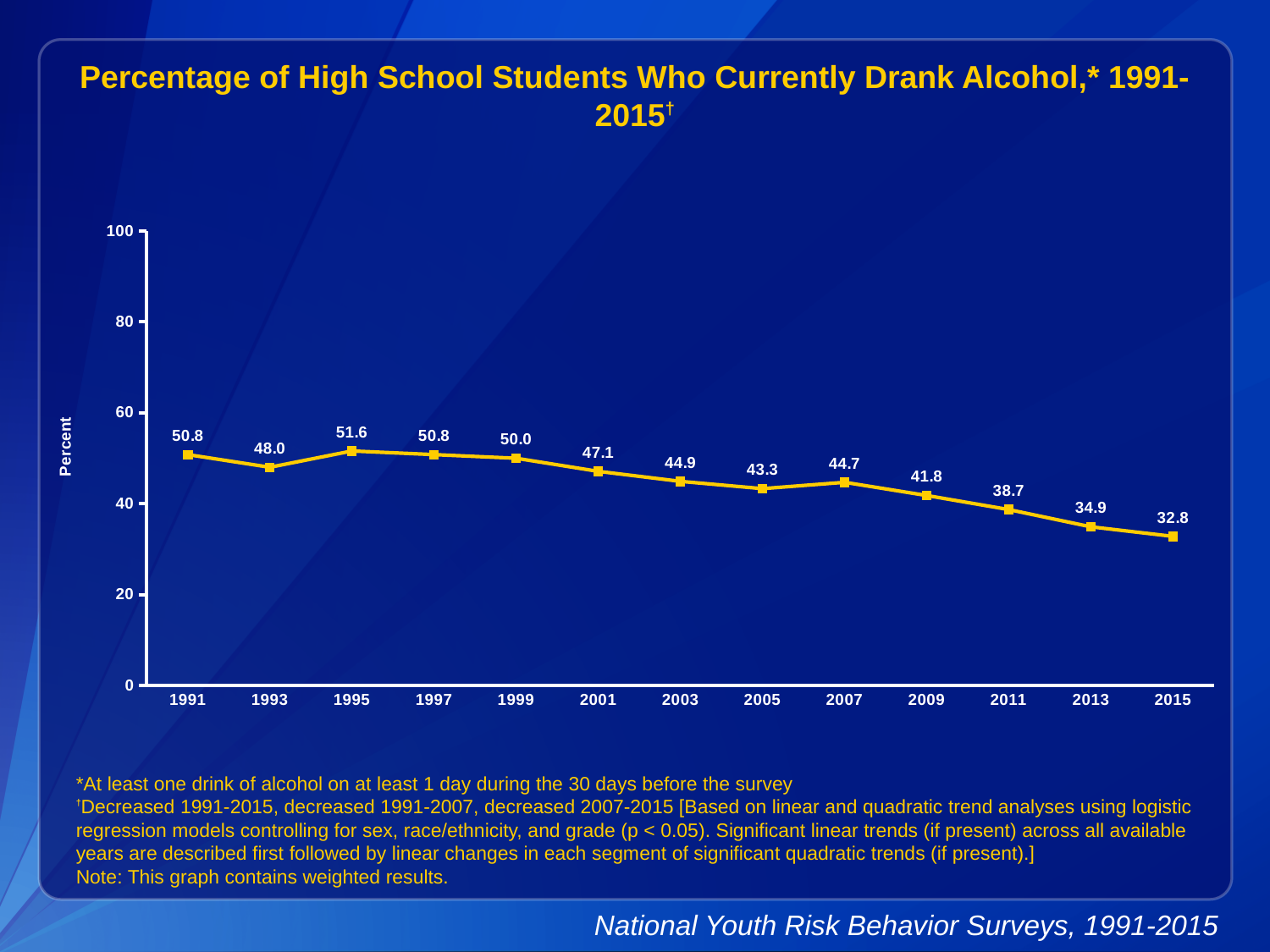
How many years are plotted on the x axis? 13 Is the value for 2011 greater or less than 40? less What is the value shown for 2015? 32.8 What is the difference between the 1991 value and the 2015 value? 18.0 Which year has a higher value, 2005 or 2007? 2007 What is the value shown for 2007? 44.7 What percentage of high school students currently drank alcohol in 1991? 50.8 Which year has the lowest percentage? 2015 Which year has the highest percentage? 1995 What kind of chart is shown on the slide? line chart Do the values generally rise or fall from 1991 to 2015? fall What is the label on the y axis? Percent